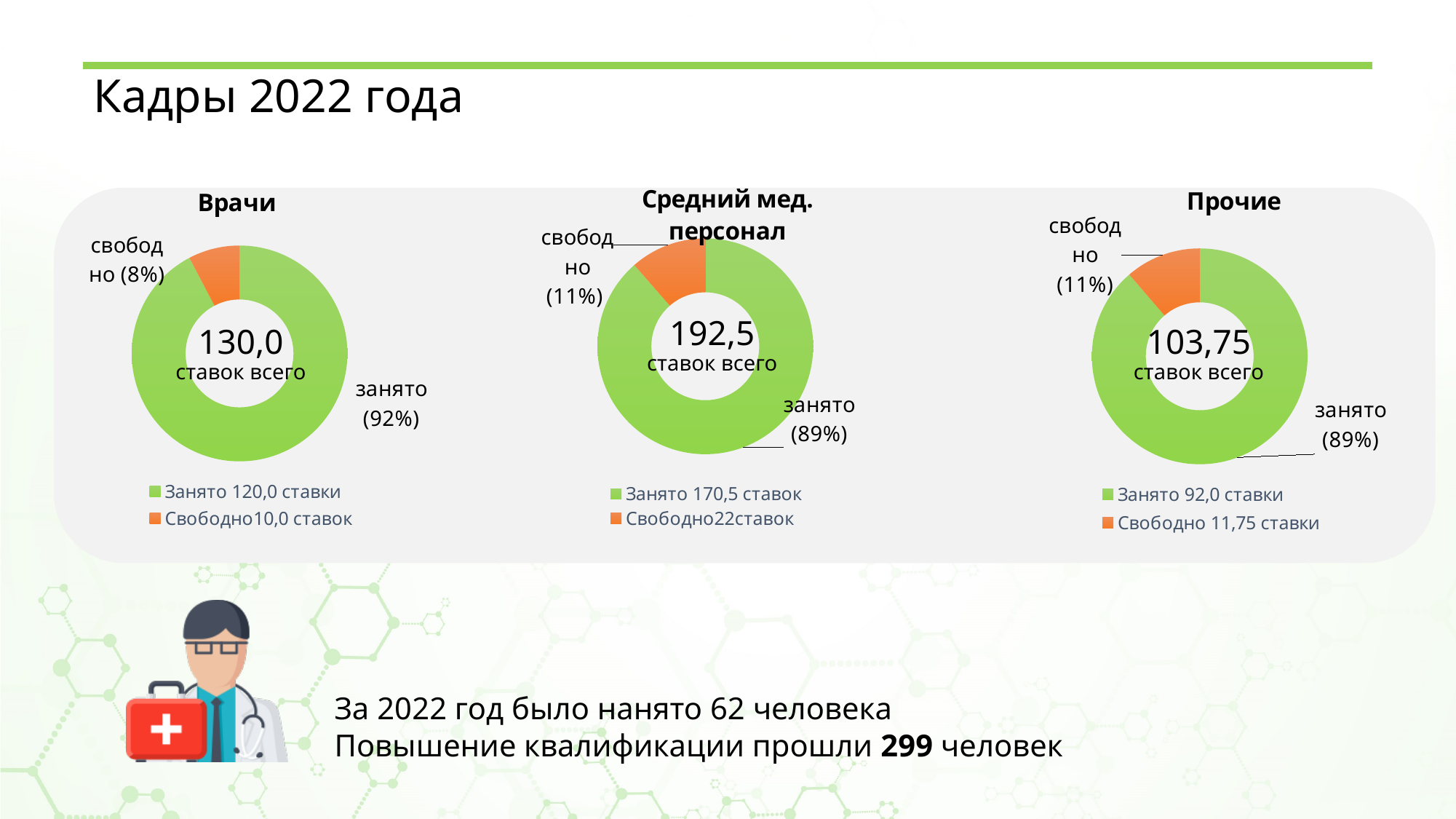
In the 'Врачи' chart, what is the total number of ставок shown in the centre? 130,0 In the 'Прочие' chart, how many ставки are listed as Свободно in the legend? 11,75 In the 'Средний мед. персонал' chart, how many ставок are listed as Свободно in the legend? 22 How many entries does the legend of the 'Прочие' chart list? 2 In the 'Врачи' chart, which slice is larger, занято or свободно? занято In the 'Средний мед. персонал' chart, what is the total number of ставок shown in the centre? 192,5 In the 'Средний мед. персонал' chart, what share of positions is свободно? 11% In the 'Прочие' chart, what is the difference between Занято and Свободно ставки? 80,25 In the 'Врачи' chart, how many ставки are listed as Занято in the legend? 120,0 What kind of chart is used for 'Средний мед. персонал'? Donut (pie) chart In the 'Прочие' chart, what share of positions is занято? 89% In the 'Врачи' chart, what share of positions is занято? 92%